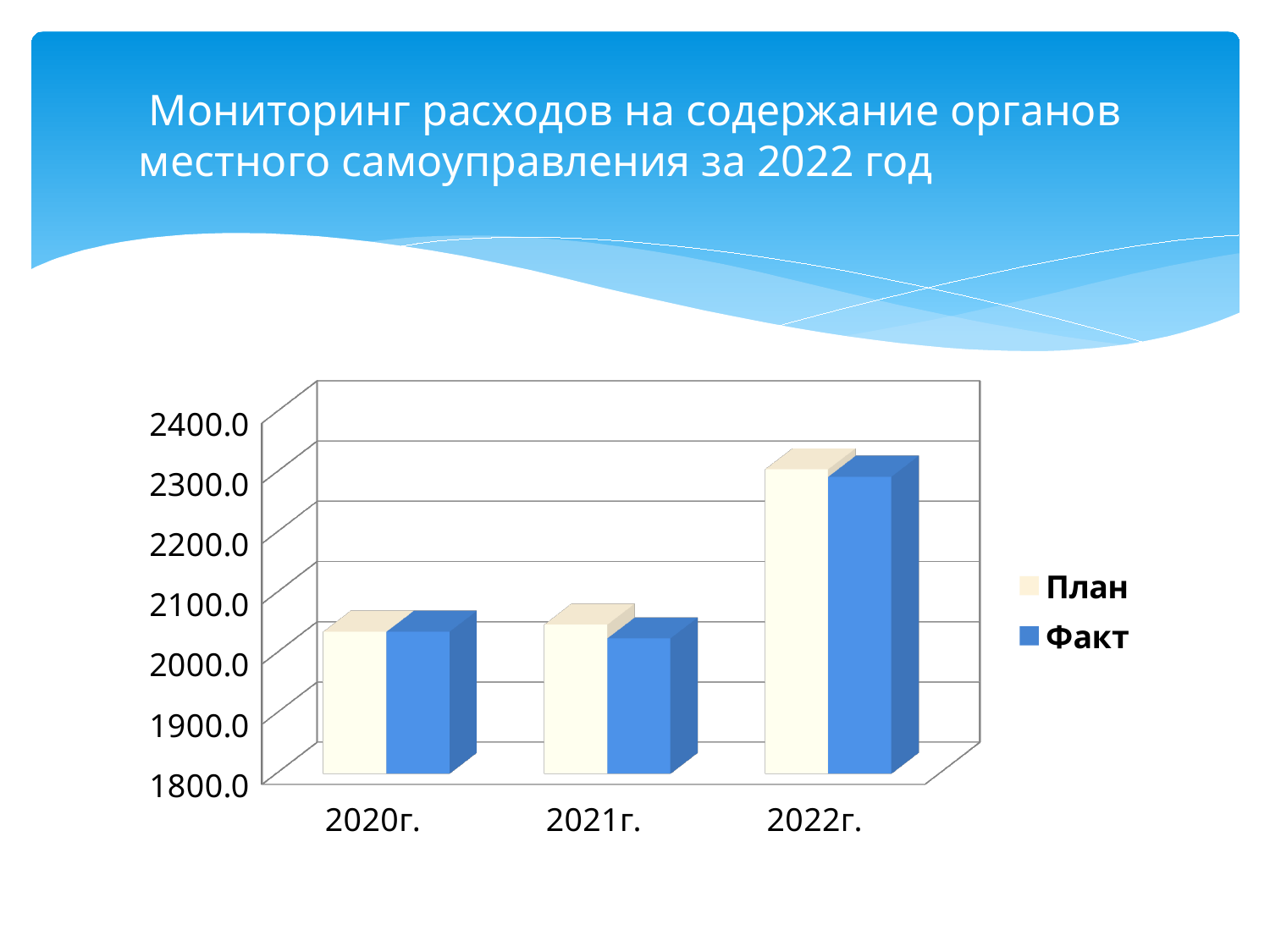
Which year has the highest value for Факт? 2022г. Is the value for Факт in 2022г. greater or less than 2200.0? greater What are the two series named in the legend? План and Факт How many series does the legend list? 2 Is the value for План in 2020г. greater or less than 2000.0? greater What is the title of the slide containing the chart? Мониторинг расходов на содержание органов местного самоуправления за 2022 год Is the value for План in 2022г. greater or less than 2200.0? greater What kind of chart is shown on the slide? bar chart Which is larger: План in 2022г. or План in 2021г.? План in 2022г. How many years (categories) are shown on the x axis? 3 Which year has the highest value for План? 2022г.